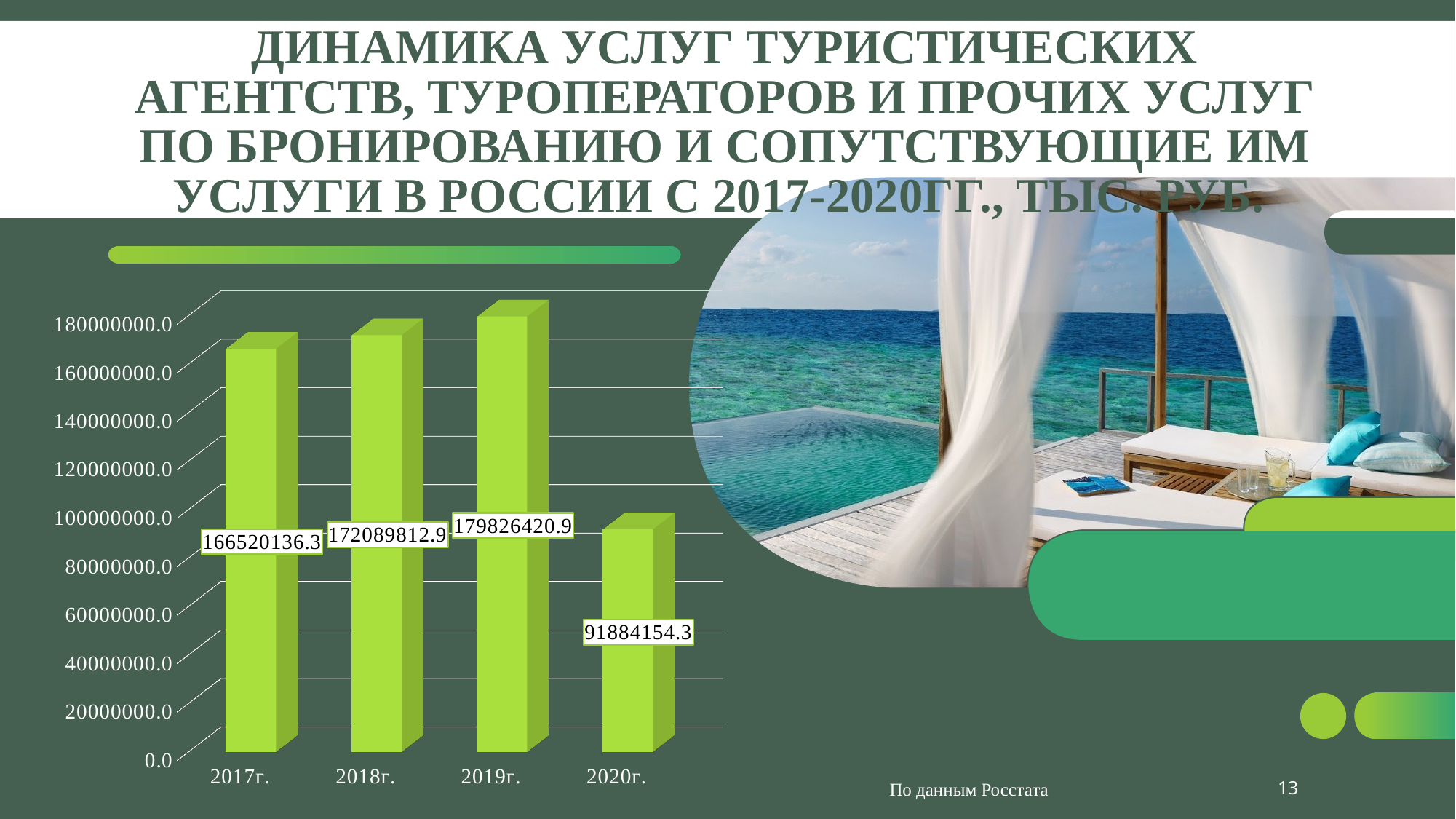
What is the value for 2019г.? 179826420.9 What is the value for 2017г.? 166520136.3 Which year has the highest value? 2019г. Which is larger, the value for 2017г. or the value for 2018г.? 2018г. Which year has the lowest value? 2020г. What is the value for 2020г.? 91884154.3 What is the difference between the values for 2019г. and 2020г.? 87942266.6 How many years are shown on the x axis? 4 Is the value for 2020г. greater or less than 100000000.0? less What kind of chart is shown on the slide? bar chart What is the difference between the values for 2019г. and 2018г.? 7736608.0 What is the value for 2018г.? 172089812.9